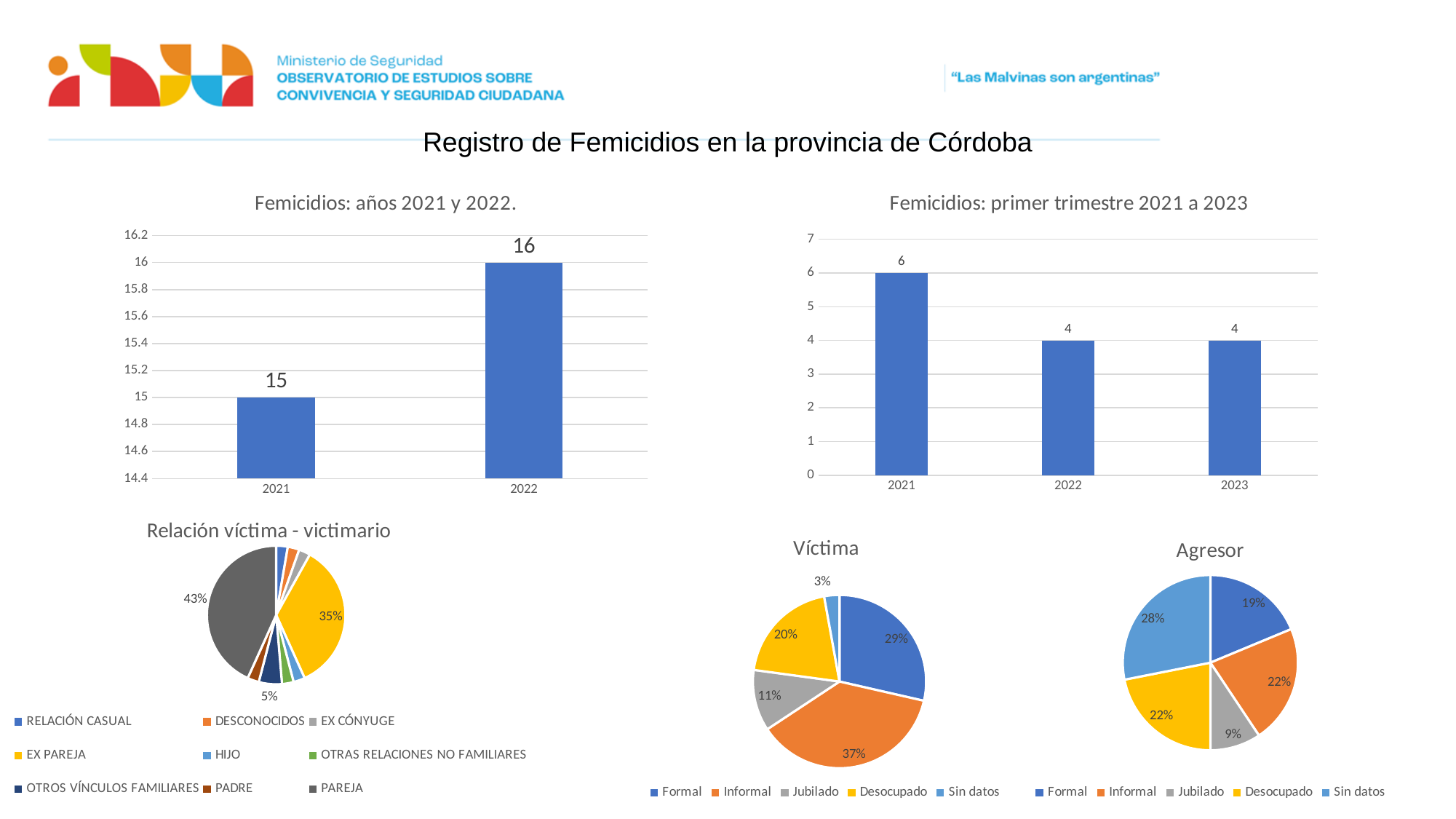
What kind of chart is 'Femicidios: años 2021 y 2022.'? bar chart In the pie chart 'Relación víctima - victimario', what share does PAREJA have? 43% In the chart 'Femicidios: primer trimestre 2021 a 2023', which year has the highest value? 2021 In the pie chart 'Víctima', what is the value for Informal? 37% How many bars are shown in the chart 'Femicidios: primer trimestre 2021 a 2023'? 3 In the pie chart 'Víctima', which is larger, Desocupado or Jubilado? Desocupado In the chart 'Femicidios: primer trimestre 2021 a 2023', what is the value for 2021? 6 In the chart 'Femicidios: años 2021 y 2022.', what is the value for 2022? 16 In the pie chart 'Agresor', what is the value for Sin datos? 28% How many categories does the legend of the pie chart 'Agresor' list? 5 In the chart 'Femicidios: años 2021 y 2022.', what is the difference between the values for 2022 and 2021? 1 In the pie chart 'Víctima', which category has the smallest share? Sin datos